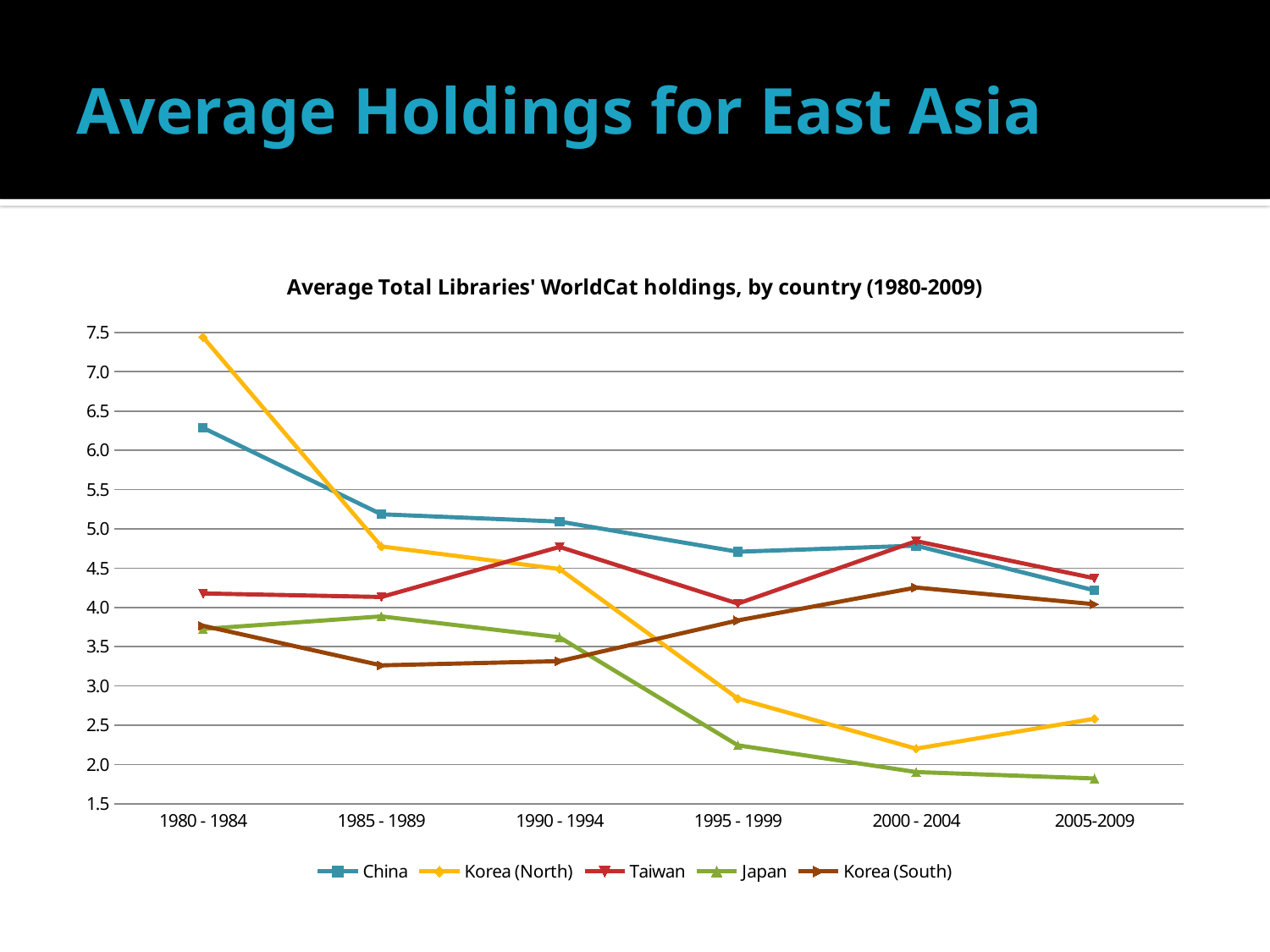
In 2005-2009, which is larger: the value for Korea (South) or the value for Korea (North)? Korea (South) Is the value for Japan in 2005-2009 greater or less than 2.0? less How many time periods are shown on the x axis? 6 In 1980 - 1984, which is larger: the value for China or the value for Taiwan? China How many series does the legend list? 5 What is the title of the chart? Average Total Libraries' WorldCat holdings, by country (1980-2009) Which country has the lowest average holdings in 2005-2009? Japan Is the value for China in 1985 - 1989 greater or less than 5.0? greater What kind of chart is shown on the slide? Line chart Do the values for Japan generally rise or fall from 1980 - 1984 to 2005-2009? Fall Which country has the highest average holdings in 1980 - 1984? Korea (North) Is the value for Korea (North) in 1980 - 1984 greater or less than 7.0? greater